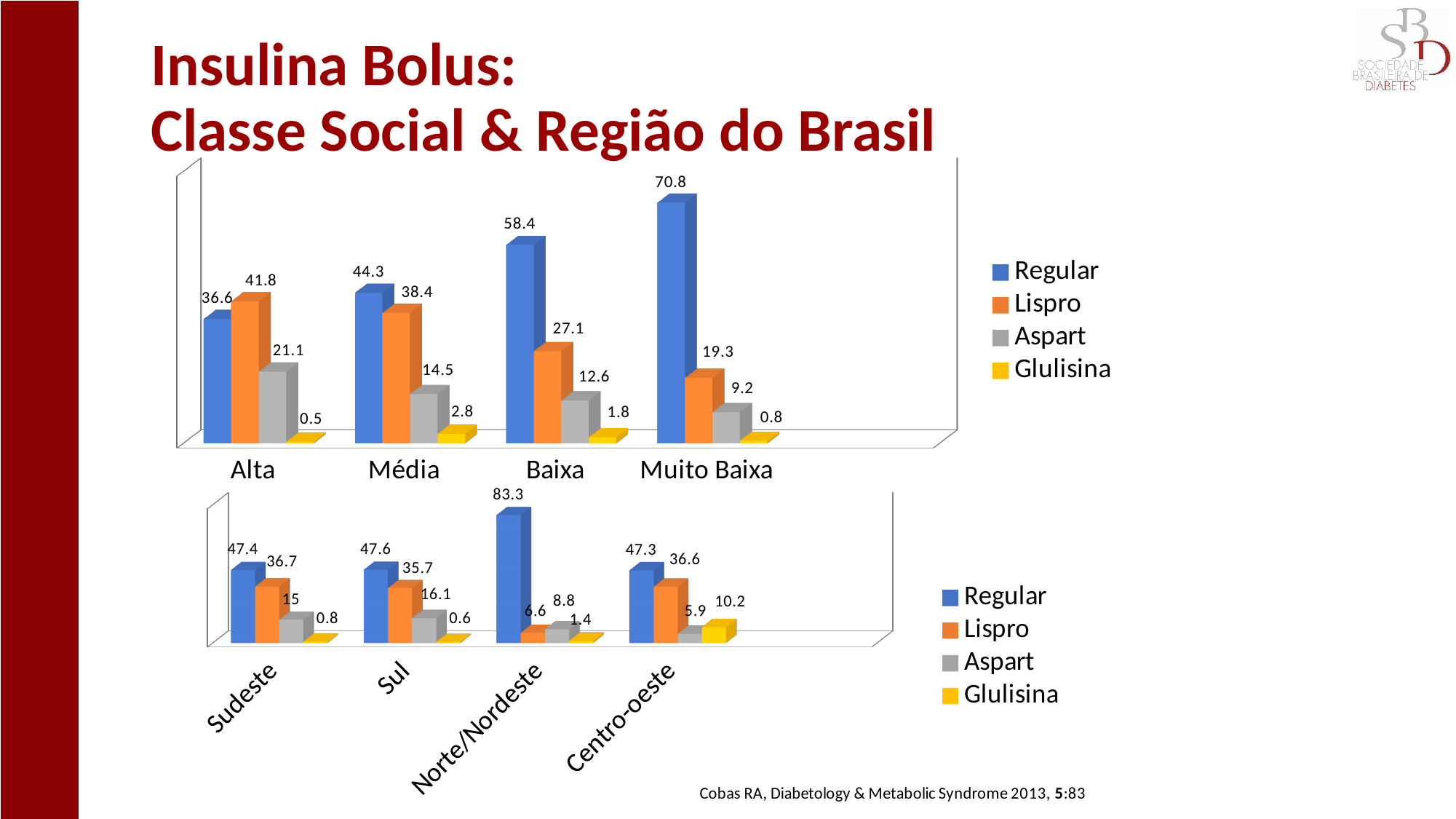
What kind of chart is the top chart (social class)? Bar chart In the bottom chart (region), what is the value for Glulisina in Centro-oeste? 10.2 In the top chart (social class), what is the value for Lispro in the Alta category? 41.8 In the top chart (social class), which category has the lowest Glulisina value? Alta In the top chart (social class), which category has the highest Regular value? Muito Baixa In the bottom chart (region), how many regions are shown on the x axis? 4 In the top chart (social class), which is larger for Alta: Regular or Lispro? Lispro In the top chart (social class), what is the value for Regular in the Muito Baixa category? 70.8 In the bottom chart (region), what is the value for Regular in Norte/Nordeste? 83.3 How many series does the legend of the bottom chart (region) list? 4 In the bottom chart (region), which region has the lowest Lispro value? Norte/Nordeste In the top chart (social class), what is the difference between the Regular and Lispro values for Baixa? 31.3